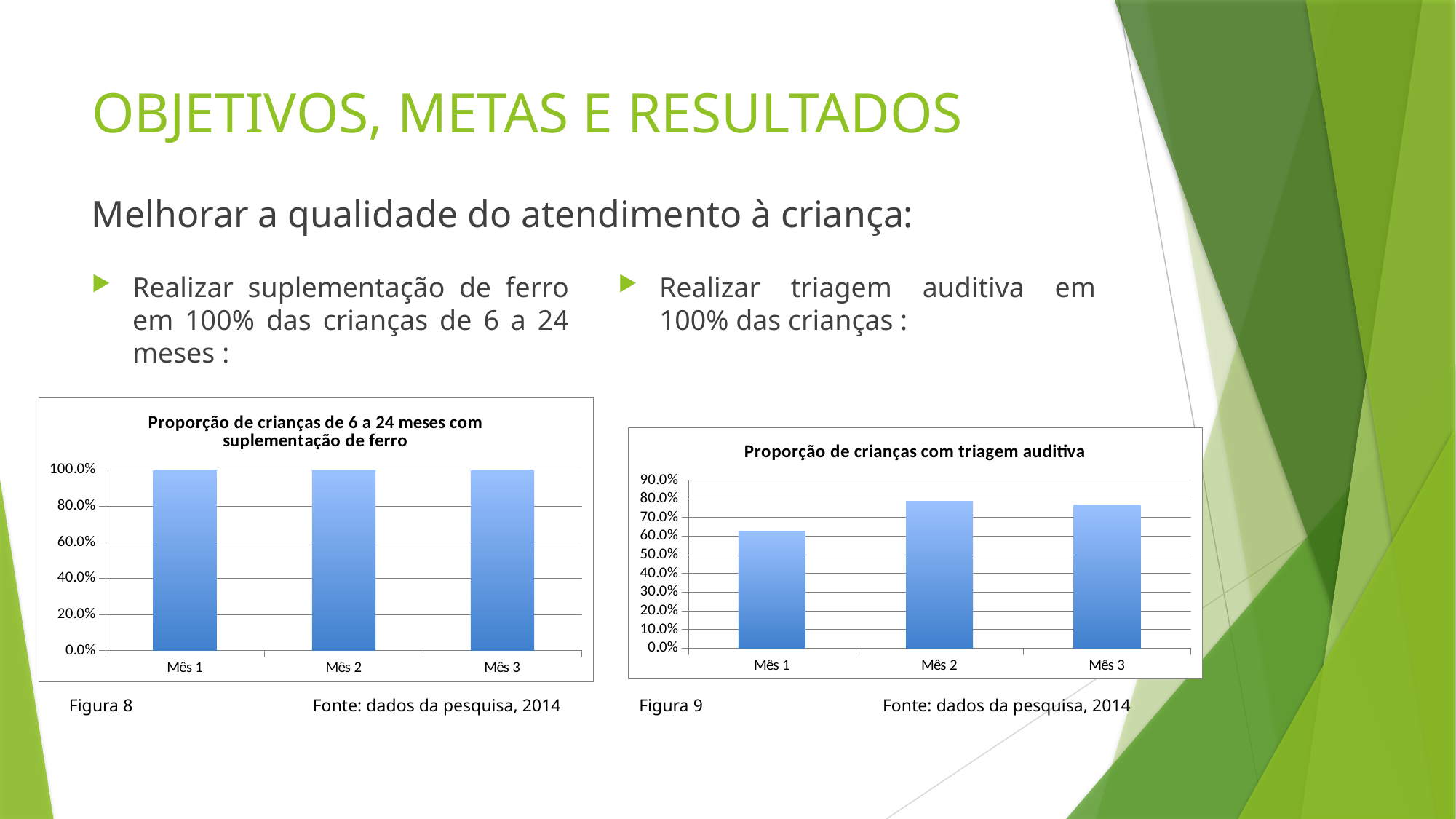
What kind of chart is the chart titled 'Proporção de crianças com triagem auditiva'? bar chart In the chart titled 'Proporção de crianças com triagem auditiva', is the value for Mês 1 greater or less than 60.0%? greater In the chart titled 'Proporção de crianças com triagem auditiva', which is larger, the value for Mês 1 or the value for Mês 2? Mês 2 In the chart titled 'Proporção de crianças de 6 a 24 meses com suplementação de ferro', how many categories are shown on the x axis? 3 What is the title of the chart on the right side of the slide? Proporção de crianças com triagem auditiva In the chart titled 'Proporção de crianças de 6 a 24 meses com suplementação de ferro', what is the value for Mês 1? 100.0% In the chart titled 'Proporção de crianças de 6 a 24 meses com suplementação de ferro', do the values rise, fall or stay the same from Mês 1 to Mês 3? stay the same In the chart titled 'Proporção de crianças com triagem auditiva', how many bars are plotted? 3 In the chart titled 'Proporção de crianças com triagem auditiva', which month has the lowest value? Mês 1 In the chart titled 'Proporção de crianças com triagem auditiva', is the value for Mês 3 greater or less than 80.0%? less In the chart titled 'Proporção de crianças com triagem auditiva', is the value for Mês 2 greater or less than 70.0%? greater In the chart titled 'Proporção de crianças de 6 a 24 meses com suplementação de ferro', what is the value for Mês 3? 100.0%